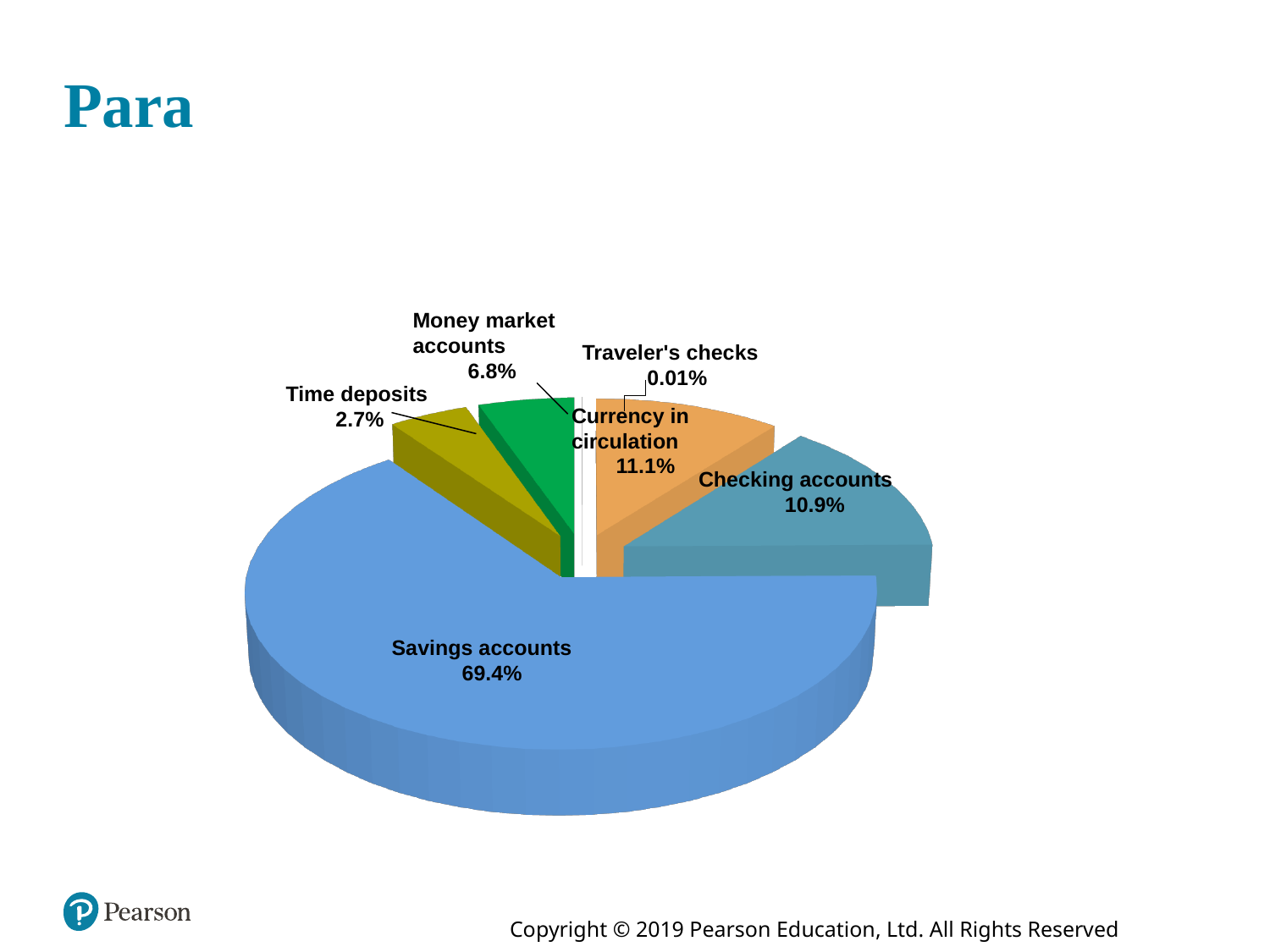
What is the difference in percentage points between Savings accounts and Currency in circulation? 58.3 What share of the pie is Money market accounts? 6.8% What share of the pie is Checking accounts? 10.9% How many slices does the pie chart have? 6 What share of the pie is Time deposits? 2.7% Which is larger, Money market accounts or Time deposits? Money market accounts What share of the pie is Traveler's checks? 0.01% Which slice of the pie is the largest? Savings accounts What kind of chart is shown on the slide? pie chart What share of the pie is Currency in circulation? 11.1% What share of the pie is Savings accounts? 69.4% Which slice of the pie is the smallest? Traveler's checks